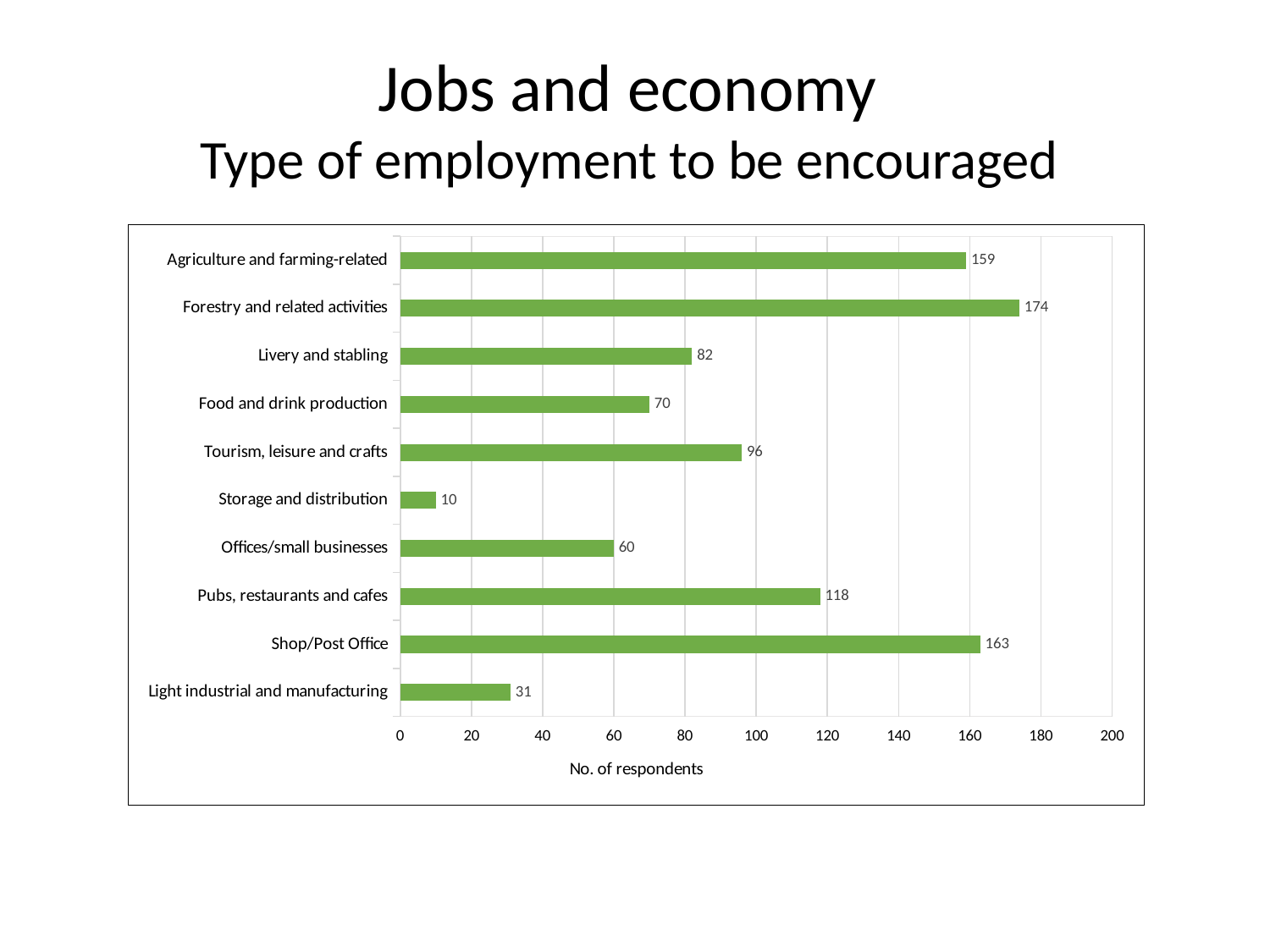
What is the difference between the values for Shop/Post Office and Agriculture and farming-related? 4 What is the value for Storage and distribution? 10 What is the number of respondents for Pubs, restaurants and cafes? 118 What is the difference between the values for Tourism, leisure and crafts and Food and drink production? 26 Is the value for Light industrial and manufacturing greater or less than 40? less What kind of chart is shown on the slide? bar chart How many respondents chose Forestry and related activities? 174 Which type of employment has the highest number of respondents? Forestry and related activities What is the label on the horizontal axis of the chart? No. of respondents How many types of employment are shown in the chart? 10 Which has more respondents, Livery and stabling or Offices/small businesses? Livery and stabling Which type of employment has the lowest number of respondents? Storage and distribution